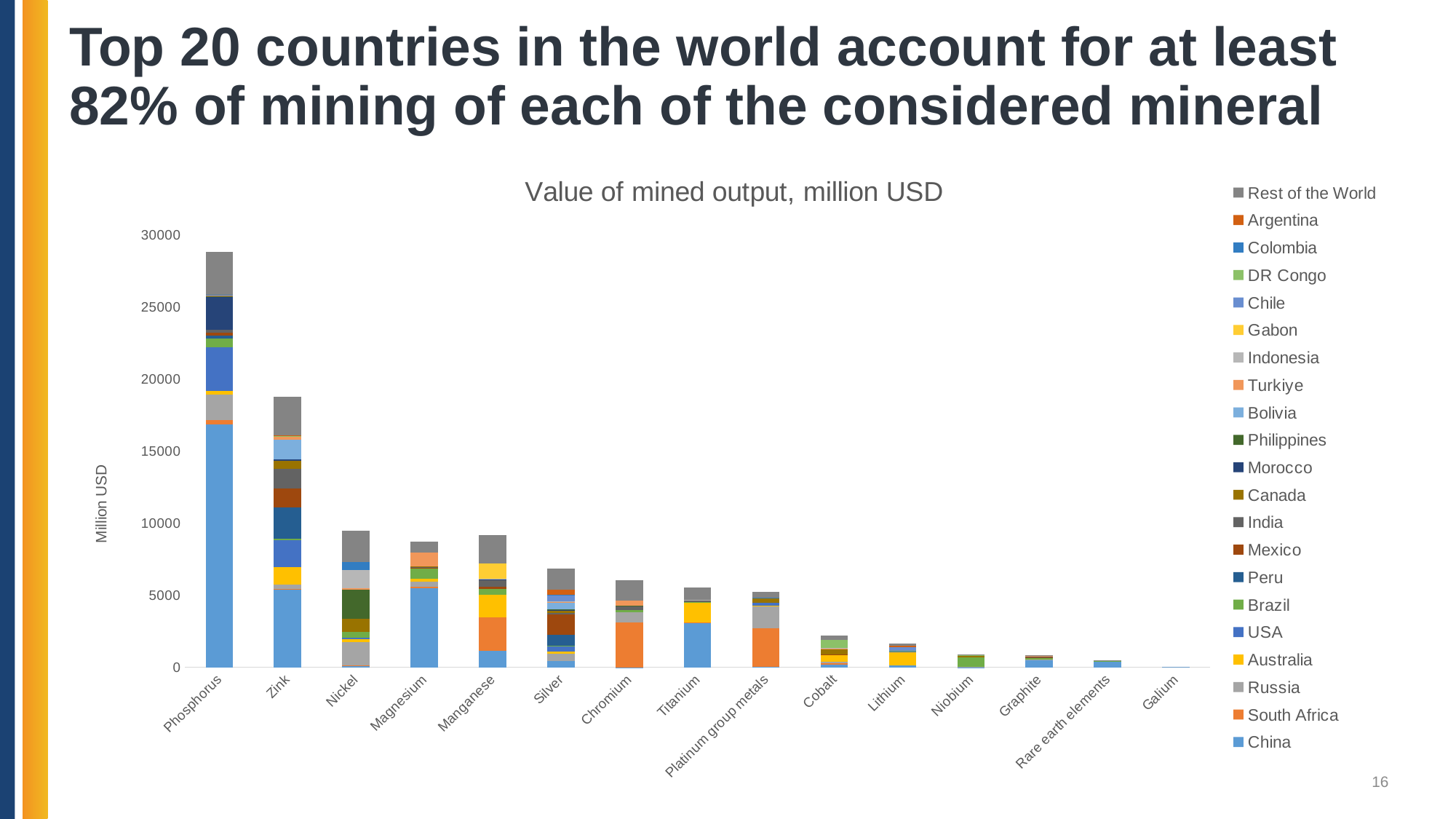
What is the title of the chart? Value of mined output, million USD Is the total value for Zink greater or less than 20000? less What kind of chart is shown on the slide? Stacked bar chart How many mineral categories are shown on the x axis of the chart? 15 Which mineral has the highest total value of mined output in the chart? Phosphorus Is the total value for Phosphorus greater or less than 25000? greater Is the total value for Cobalt greater or less than 5000? less Which mineral has the lowest total value of mined output in the chart? Galium Do the total bar values generally rise or fall from left to right along the x axis? fall How many series does the legend of the chart list? 21 Which has a larger total value of mined output, Zink or Nickel? Zink